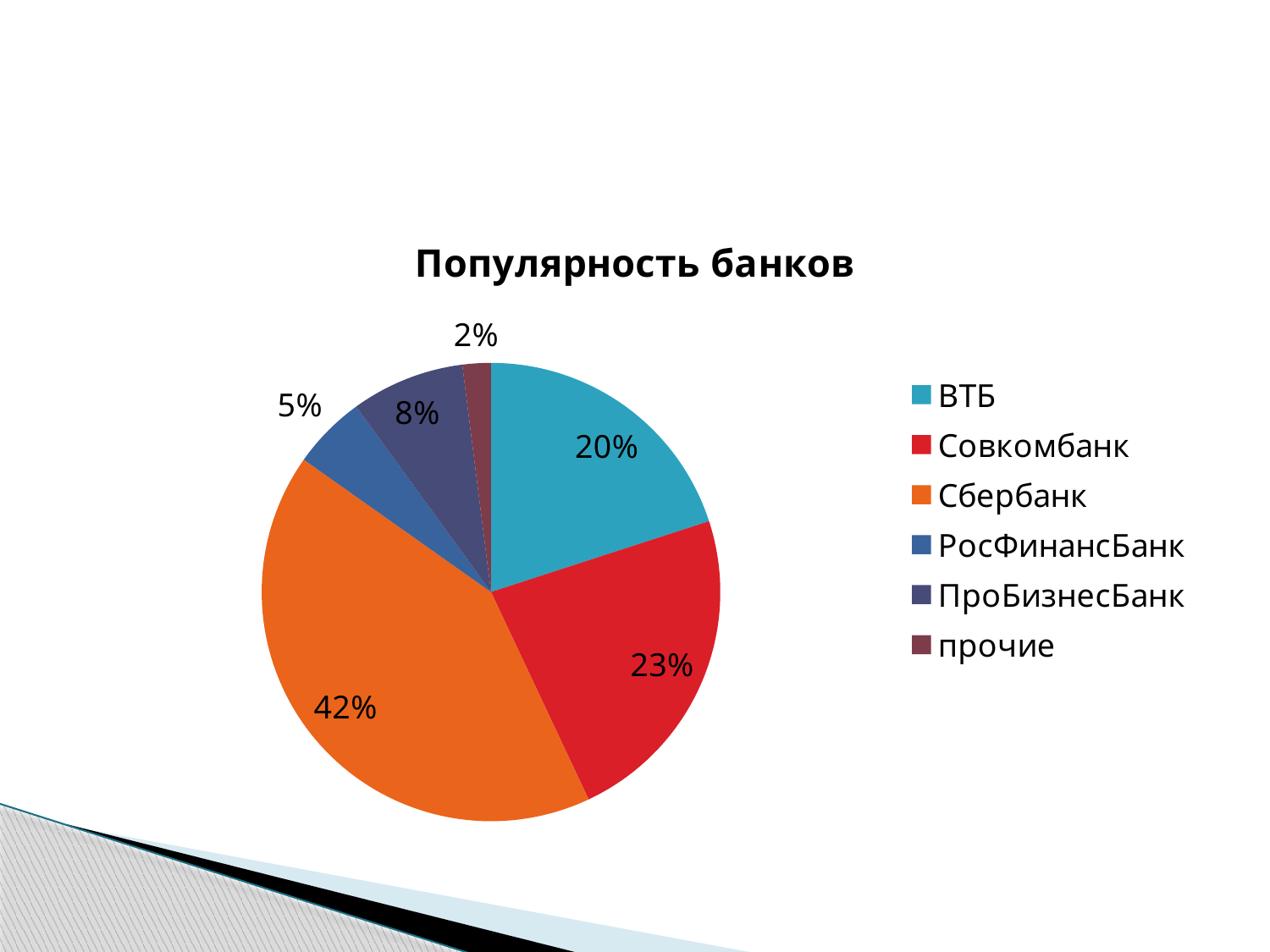
How many categories does the pie chart show? 6 Which bank has the largest slice of the pie? Сбербанк What is the value shown for ВТБ? 20% What is the value shown for Совкомбанк? 23% What share of the pie does Сбербанк hold? 42% What kind of chart is shown on the slide? Pie chart What is the difference between the shares of Сбербанк and Совкомбанк? 19% What is the title of the chart? Популярность банков What is the difference between the shares of РосФинансБанк and прочие? 3% Which is larger, the share of ВТБ or the share of Совкомбанк? Совкомбанк What is the value shown for ПроБизнесБанк? 8% Which category has the smallest slice of the pie? прочие